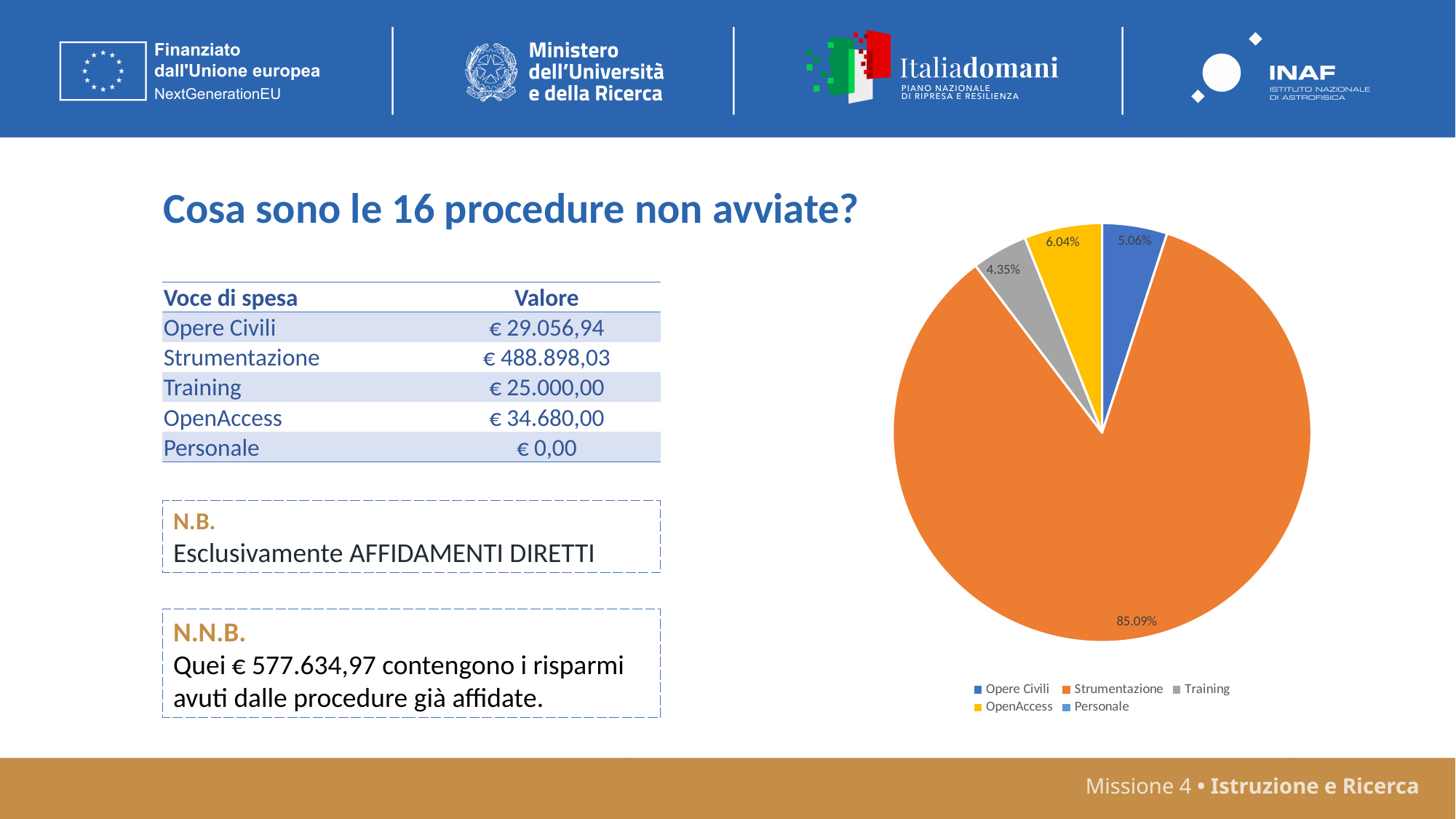
What percentage share does the Strumentazione slice have in the pie chart? 85.09% Which of the labelled slices in the pie chart is the smallest? Training Which legend entry of the pie chart is shown in yellow? OpenAccess Which category has the largest slice in the pie chart? Strumentazione What percentage share does the Opere Civili slice have in the pie chart? 5.06% What colour is the Strumentazione slice in the pie chart? orange What is the difference in percentage points between the OpenAccess and Training slices in the pie chart? 1.69% What kind of chart is shown on the slide? pie chart What percentage share does the Training slice have in the pie chart? 4.35% Which slice is larger in the pie chart, OpenAccess or Opere Civili? OpenAccess How many entries does the legend of the pie chart list? 5